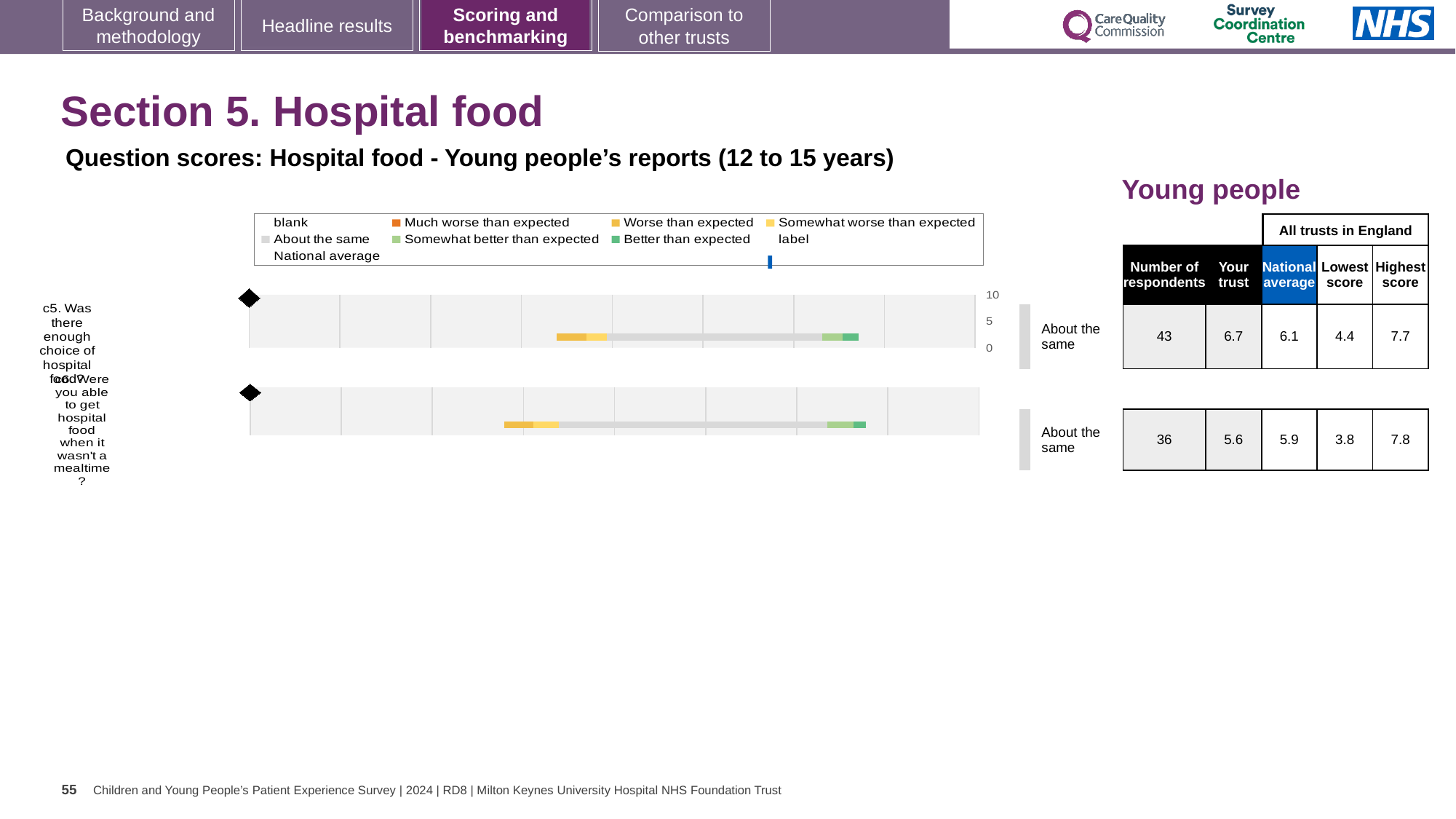
What kind of chart is shown on the slide? bar chart In the table beside the chart, what is the national average for c5? 6.1 Which legend entry is shown in dark green? Better than expected How many entries does the chart legend list? 9 Which question has the higher 'Your trust' score, c5 or c6? c5 In the table beside the chart, how many respondents answered c5 (Was there enough choice of hospital food?)? 43 What benchmark category is given for both c5 and c6? About the same In the table beside the chart, what is the highest score for c6? 7.8 In the table beside the chart, what is the 'Your trust' score for c6 (Were you able to get hospital food when it wasn't a mealtime?)? 5.6 How many questions (categories) are plotted in the chart? 2 What is the difference between the 'Your trust' scores for c5 and c6? 1.1 What is the highest value shown on the chart's axis? 10